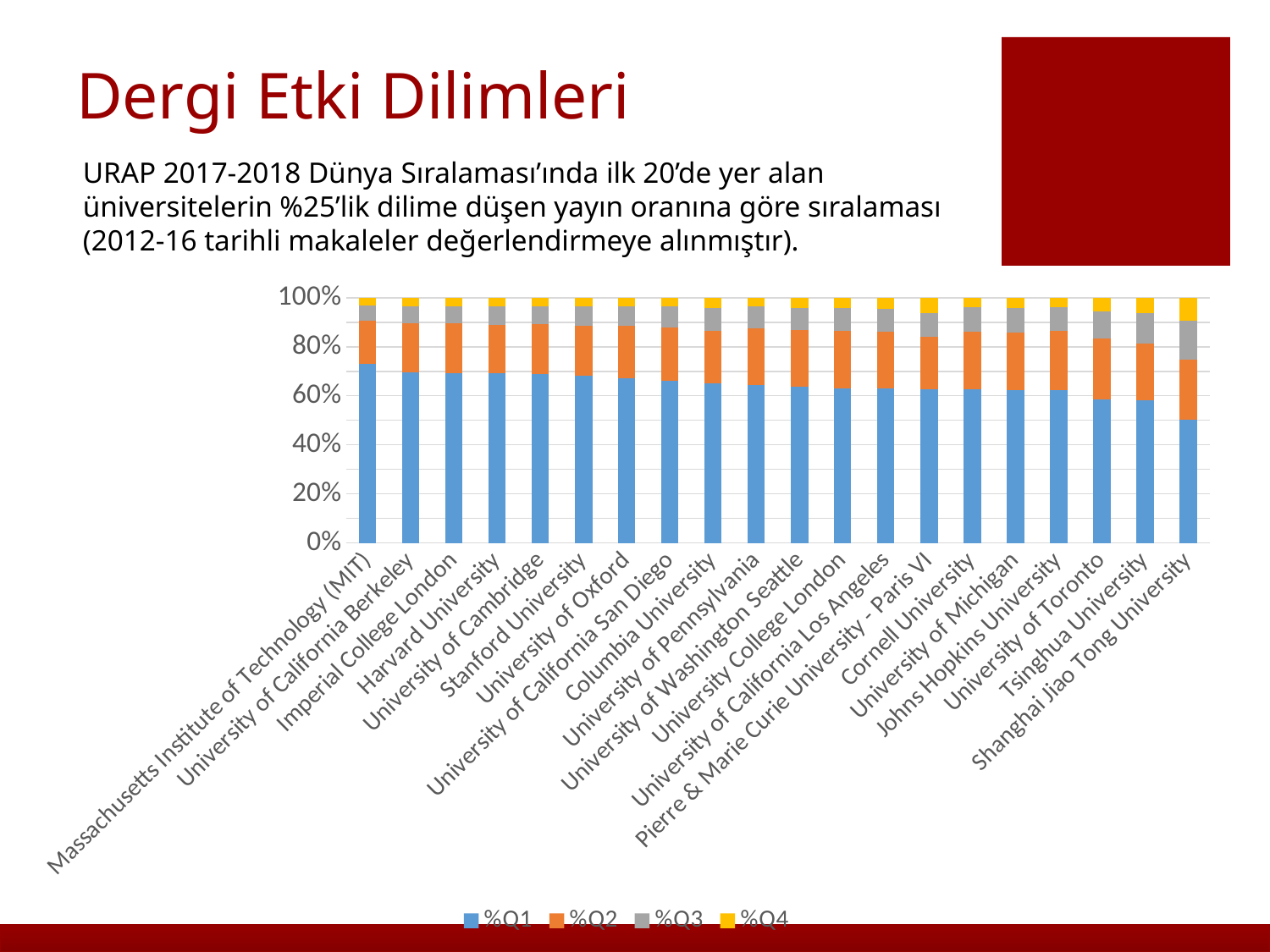
Which university has the highest %Q1 share in the chart? Massachusetts Institute of Technology (MIT) Which university has the lowest %Q1 share in the chart? Shanghai Jiao Tong University Is the %Q1 value for Shanghai Jiao Tong University greater or less than 60%? less Is the %Q1 value for Massachusetts Institute of Technology (MIT) greater or less than 60%? greater Which has a larger %Q1 share: University of California Berkeley or Shanghai Jiao Tong University? University of California Berkeley What are the series names listed in the chart legend? %Q1, %Q2, %Q3, %Q4 How many series does the chart legend list? 4 What is the total height of the stacked bar for Harvard University? 100% Is the %Q1 value for Harvard University greater or less than 60%? greater What kind of chart is shown on the slide? Stacked bar chart How many universities are shown on the x axis of the chart? 20 Does the %Q1 share rise or fall moving from left to right along the x axis? Fall